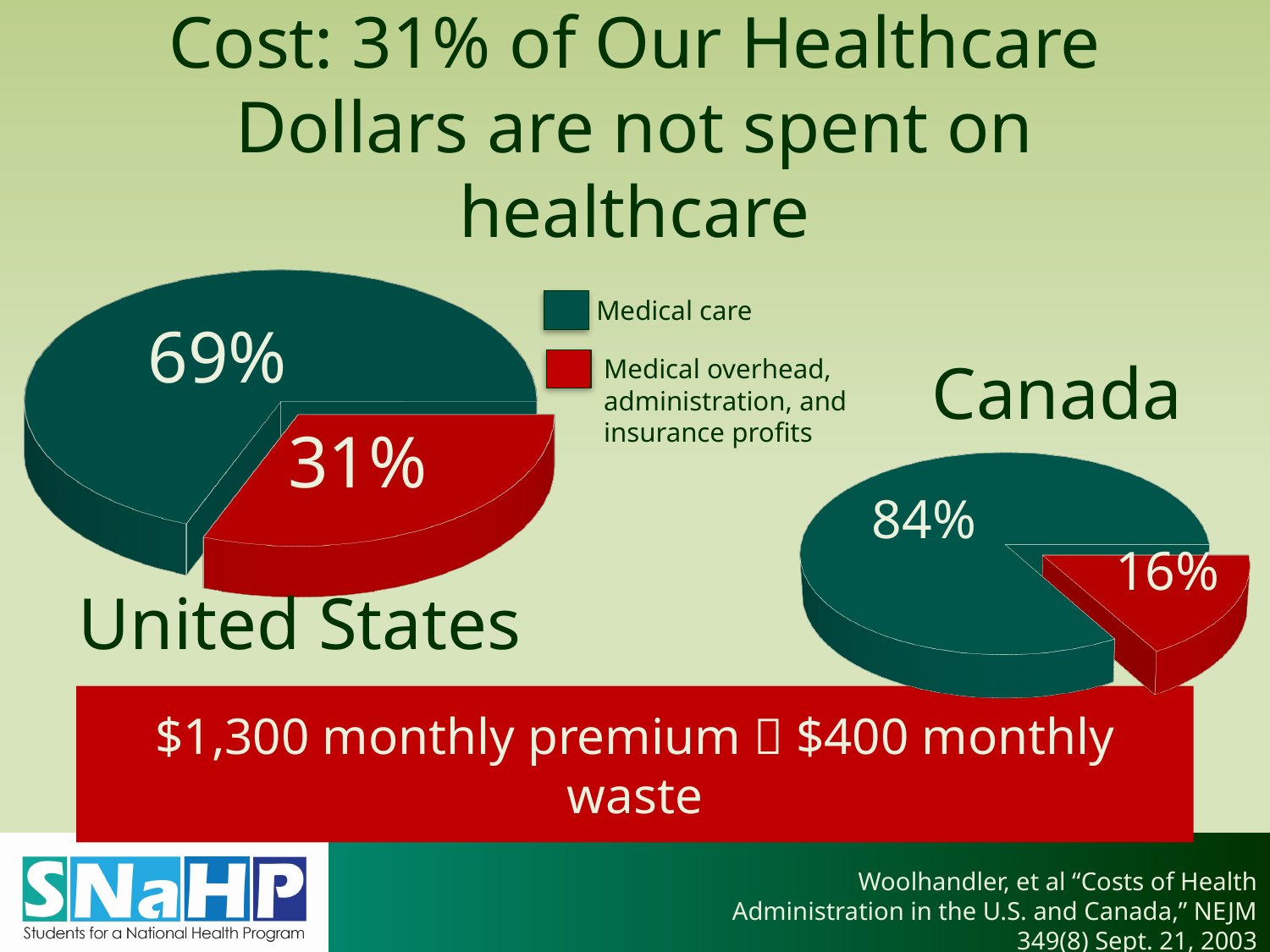
In the United States pie chart, which slice is the largest? Medical care In the United States pie chart, what share is Medical care? 69% What is the difference between the Medical overhead share in the United States pie chart and in the Canada pie chart? 15% What colour represents Medical care in the legend? Teal (dark green) Which country's pie chart shows a larger share for Medical overhead, administration, and insurance profits, United States or Canada? United States In the United States pie chart, what share is Medical overhead, administration, and insurance profits? 31% How many slices does the Canada pie chart have? 2 What kind of chart is used for the United States and Canada data? Pie chart In the Canada pie chart, what share is Medical care? 84% In the Canada pie chart, which slice is the smallest? Medical overhead, administration, and insurance profits What is the difference between the Medical care share in the Canada pie chart and in the United States pie chart? 15% In the Canada pie chart, what share is Medical overhead, administration, and insurance profits? 16%